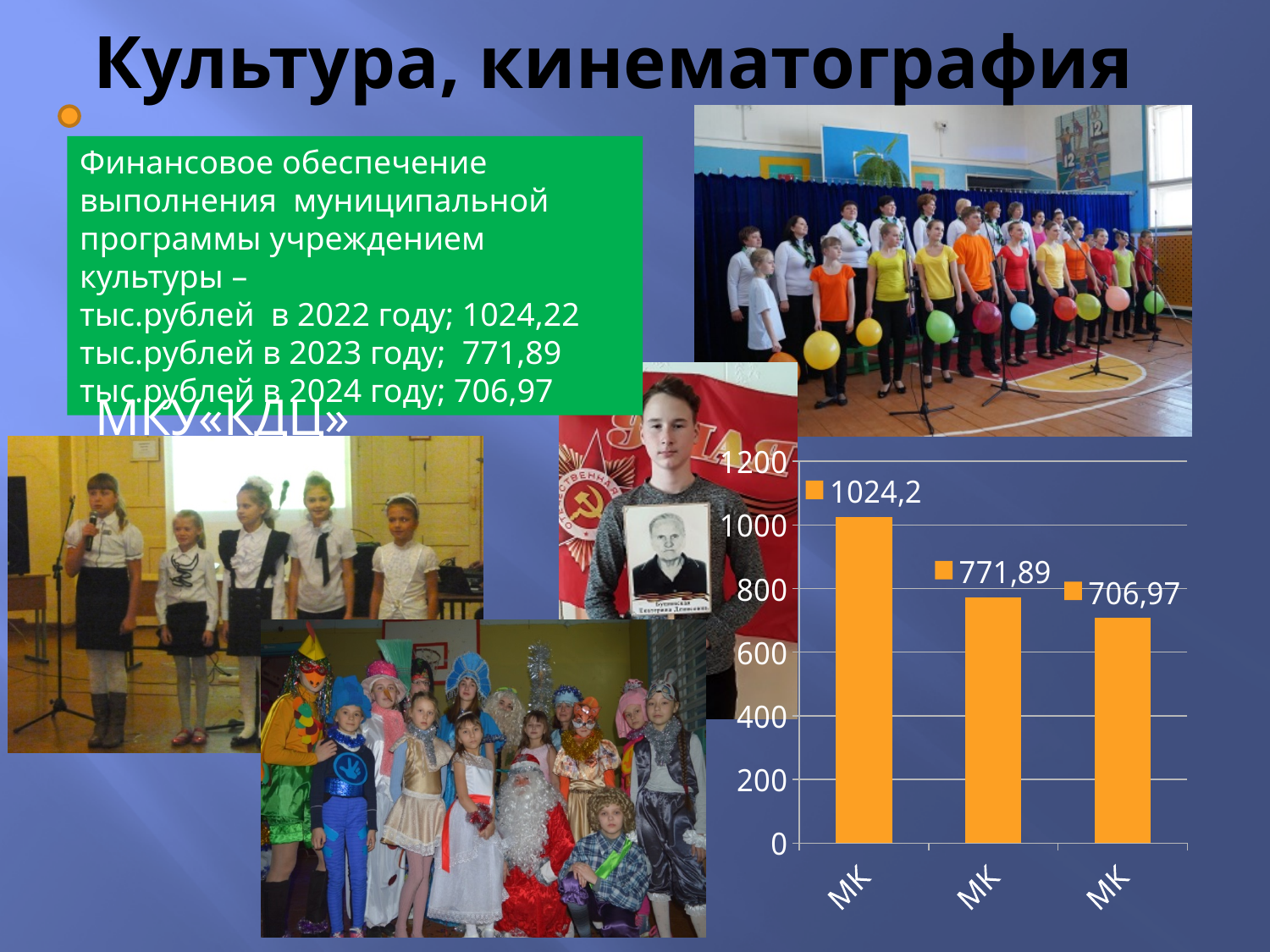
What value is shown on the data label of the rightmost bar in the chart? 706,97 Which is larger: the middle bar or the rightmost bar? The middle bar (771,89) Do the values in the chart rise or fall from left to right? Fall Is the value of the leftmost bar greater or less than 1000? greater Which bar in the chart is the lowest? The rightmost bar (706,97) How many bars are plotted in the chart? 3 What value is shown on the data label of the middle bar in the chart? 771,89 What is the difference between the middle bar (771,89) and the rightmost bar (706,97)? 64,92 Which bar in the chart is the highest? The leftmost bar (1024,2) What is the difference between the leftmost bar (1024,2) and the middle bar (771,89)? 252,31 What value is shown on the data label of the leftmost bar in the chart? 1024,2 What kind of chart is shown on the slide? Bar chart